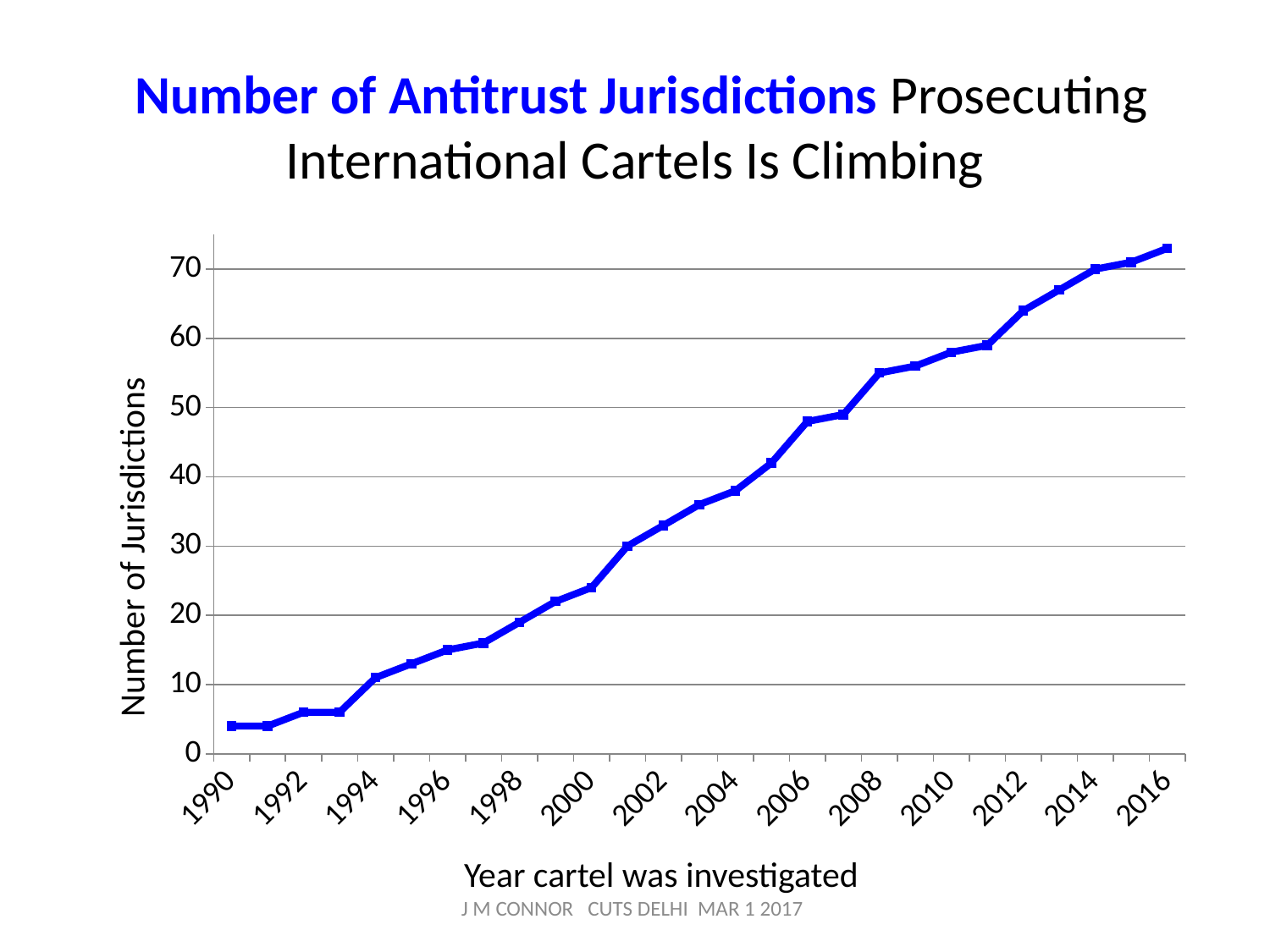
What kind of chart is shown on the slide? line chart Which year has the highest number of jurisdictions? 2016 What is the title of the horizontal axis? Year cartel was investigated Is the value for 2016 greater or less than 70? greater What is the title of the vertical axis? Number of Jurisdictions Is the value for 2008 greater or less than 50? greater Which year has the larger value, 2000 or 2008? 2008 Is the value for 2000 greater or less than 30? less Do the values rise or fall from 1990 to 2016? rise